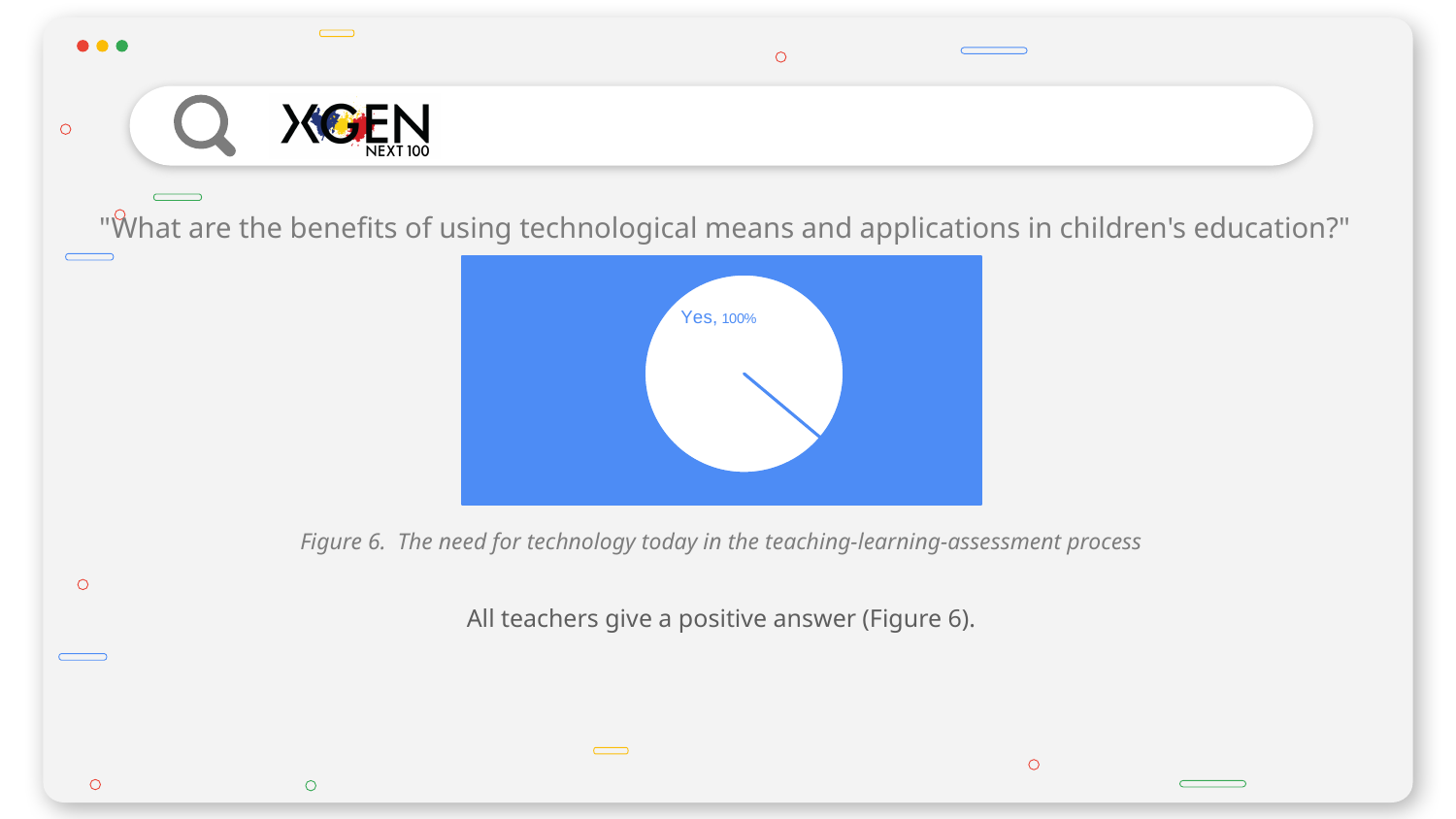
What is the figure caption below the pie chart? Figure 6. The need for technology today in the teaching-learning-assessment process What colour is the "Yes" slice of the pie chart? white How many slices does the pie chart have? 1 What share of the pie does the "Yes" slice represent? 100% What kind of chart is shown on the slide? pie chart Which category is the largest in the pie chart? Yes What is the value shown for the "Yes" category in the pie chart? 100% Is the value for "Yes" greater or less than 50%? greater